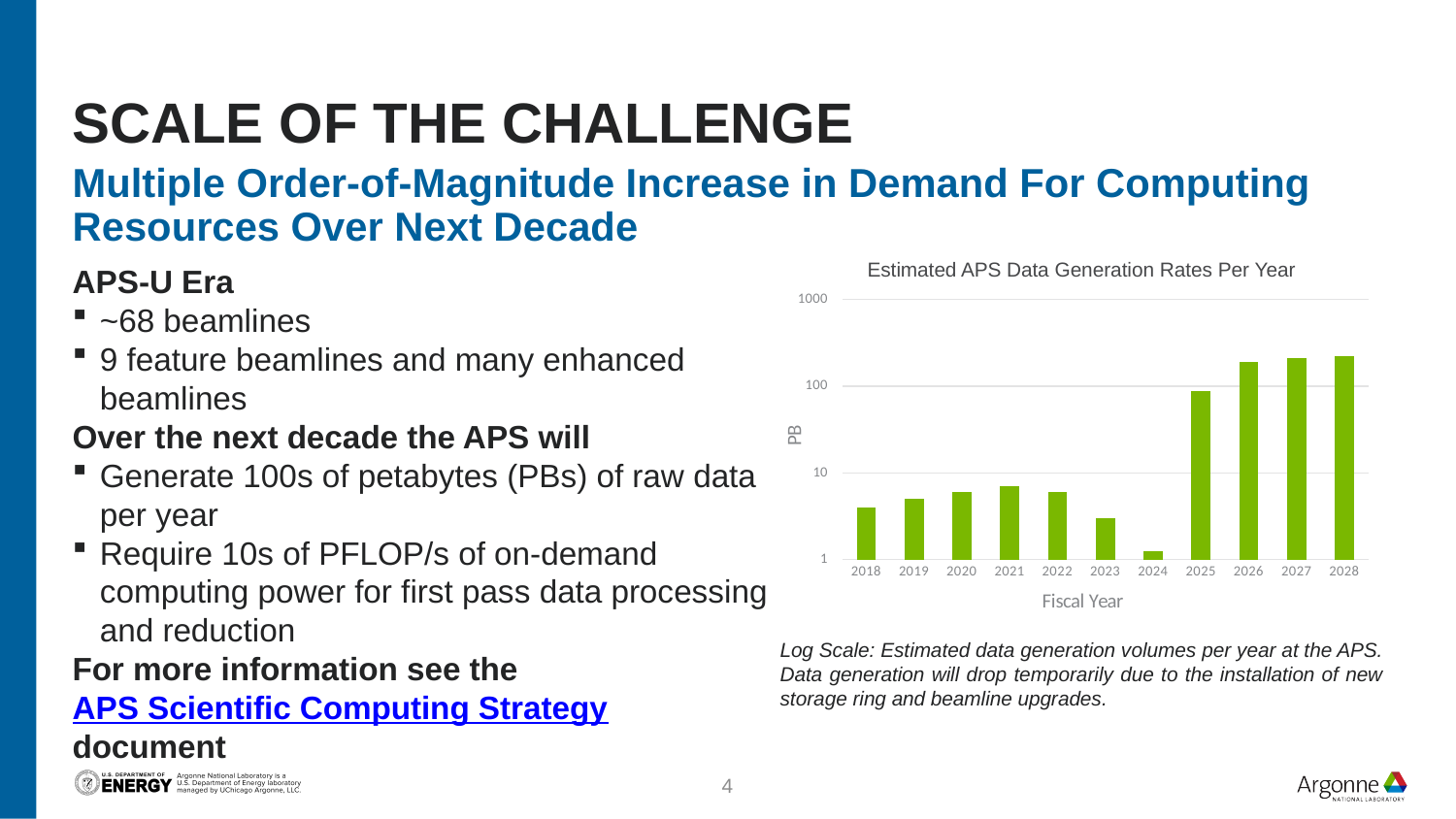
How many fiscal years are plotted in the chart? 11 Is the value for 2026 greater or less than 100? greater Is the value for 2018 greater or less than 10? less What is the label on the y axis of the chart? PB What kind of chart is shown on the slide? bar chart Which fiscal year has the lowest estimated data generation rate? 2024 Do the values rise or fall from 2021 to 2024? fall Is the value for 2028 greater or less than 1000? less Which fiscal year has the larger value, 2023 or 2025? 2025 Which fiscal year has the larger value, 2021 or 2024? 2021 What is the title of the chart? Estimated APS Data Generation Rates Per Year